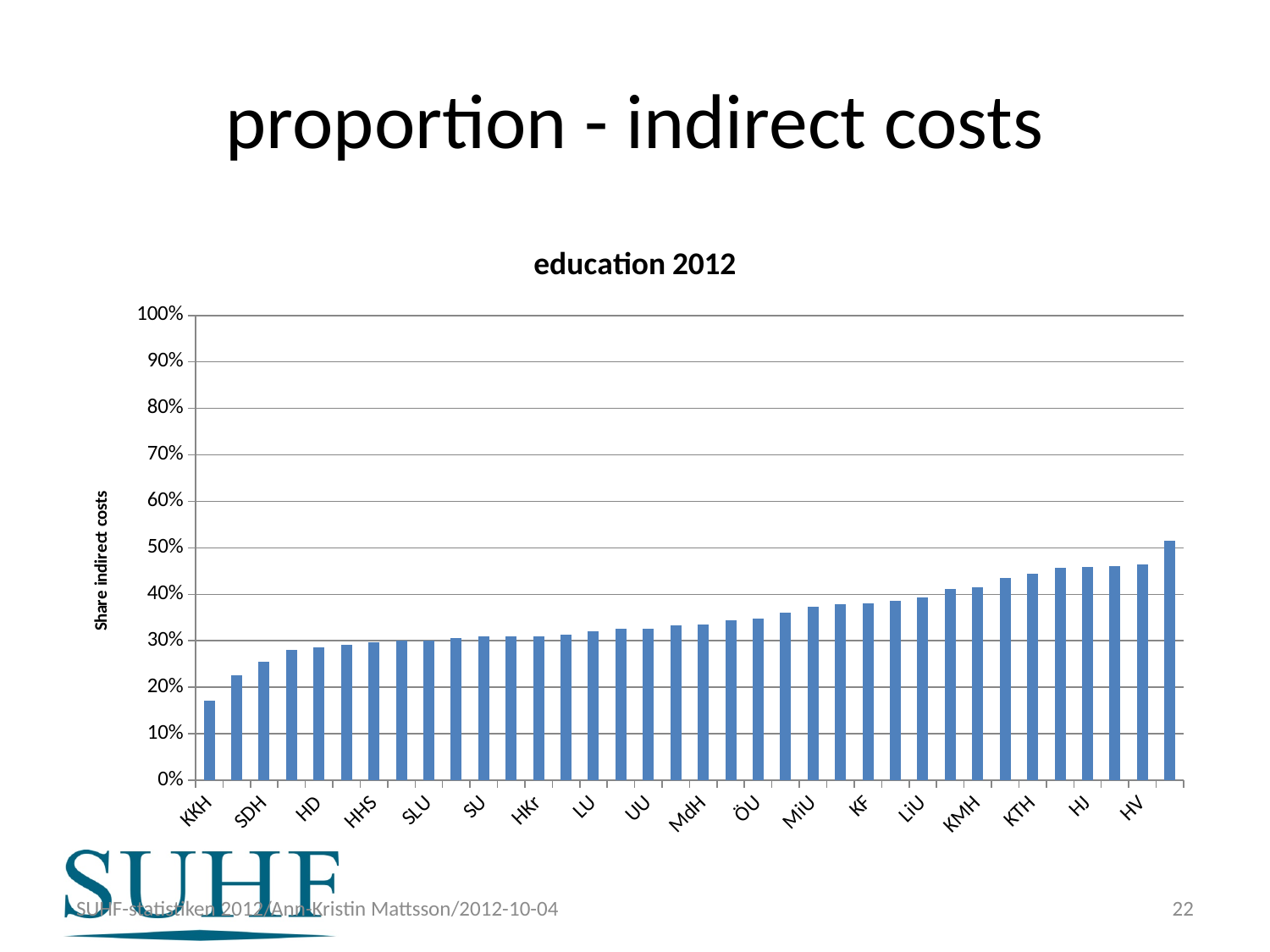
Is the value for SDH greater or less than 20%? greater Is the value for HV greater or less than 50%? less Which labelled category has the lowest share of indirect costs? KKH Is the value for KKH greater or less than 20%? less What is the label on the vertical axis of the chart? Share indirect costs Do the values generally rise or fall from left to right along the x axis? rise What kind of chart is shown on the slide? bar chart Which has a larger share of indirect costs, SDH or KTH? KTH What is the title of the chart? education 2012